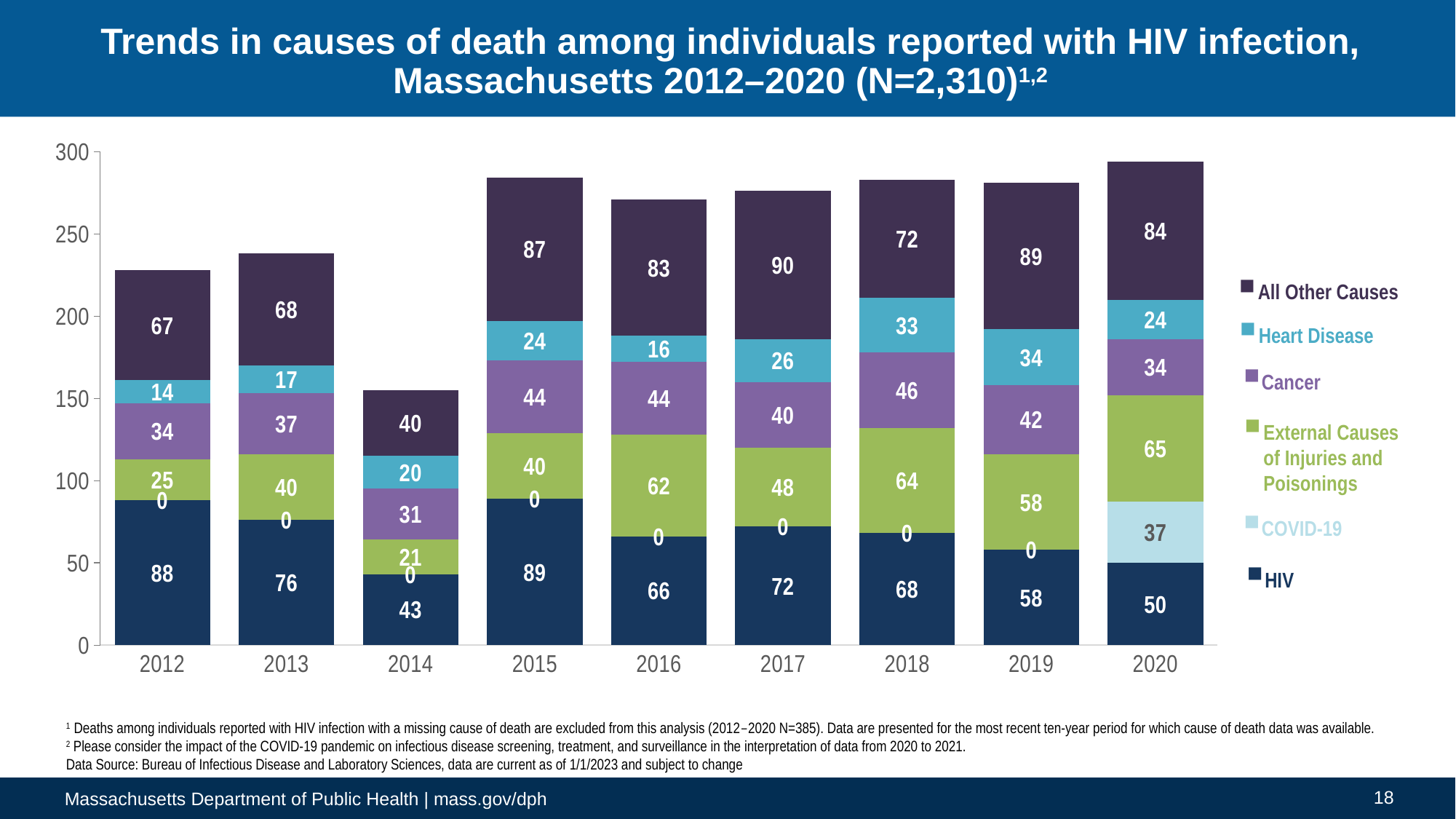
How many HIV deaths were reported in 2012? 88 Does the HIV value rise or fall from 2015 to 2020? Fall In which year was the HIV value highest? 2015 How many years are shown on the x axis? 9 What kind of chart is shown on the slide? Stacked bar chart What is the total of the stacked bar for 2014? 155 How many series does the legend list? 6 What is the difference between the All Other Causes value in 2017 and in 2012? 23 In which year was the HIV value lowest? 2014 In which year was the All Other Causes value highest? 2017 Which year has the larger Cancer value, 2018 or 2019? 2018 What is the value for COVID-19 in 2020? 37